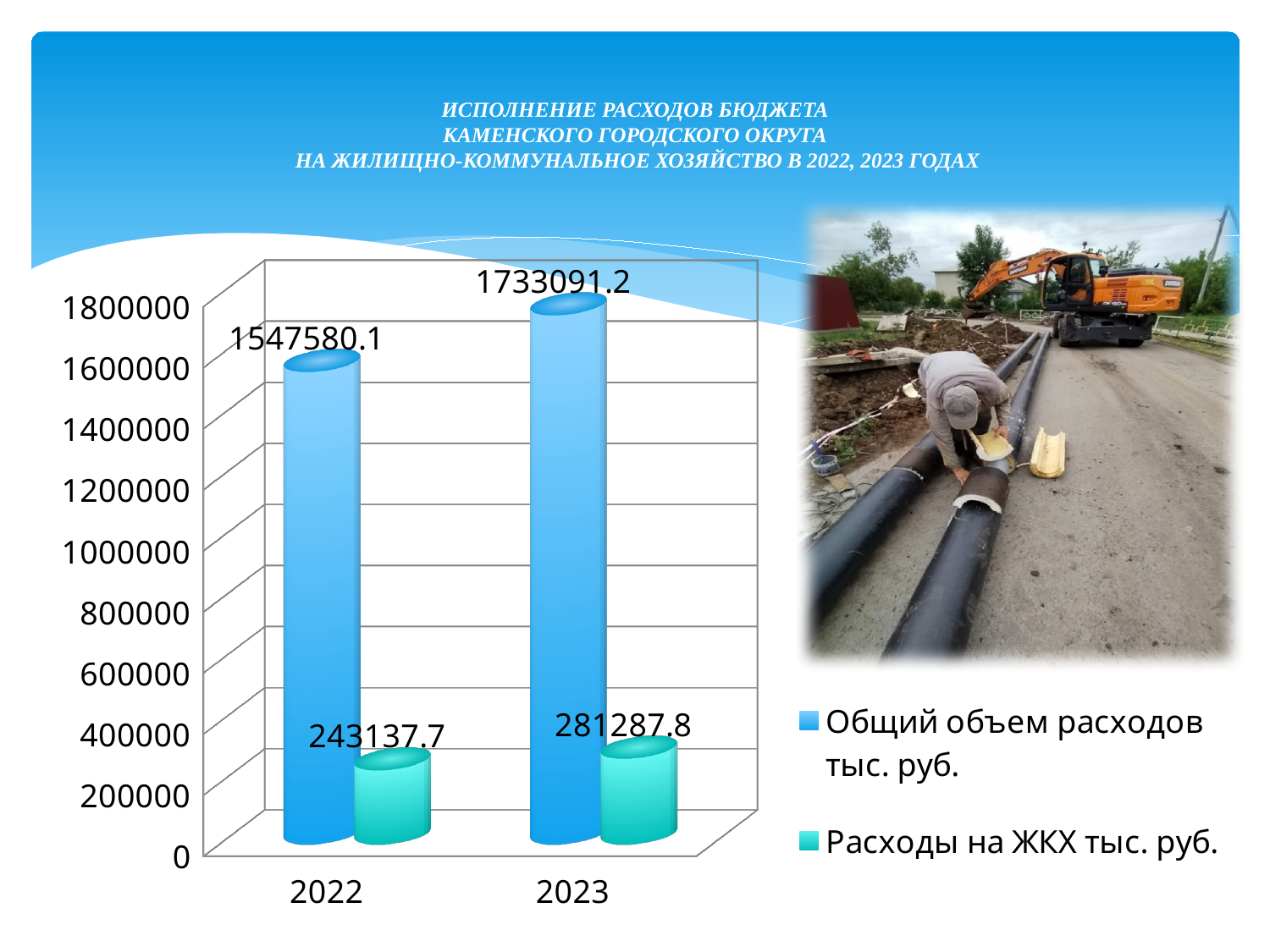
Is the value for "Расходы на ЖКХ тыс. руб." in 2023 greater or less than 400000? less How many series does the chart legend list? 2 What is the value of "Общий объем расходов тыс. руб." for 2022? 1547580.1 What is the value of "Расходы на ЖКХ тыс. руб." for 2023? 281287.8 What type of chart is shown on the slide? Bar chart Which year has the lower value for "Расходы на ЖКХ тыс. руб."? 2022 What is the value of "Расходы на ЖКХ тыс. руб." for 2022? 243137.7 What is the difference between "Расходы на ЖКХ тыс. руб." in 2023 and in 2022? 38150.1 By how much did "Общий объем расходов тыс. руб." increase from 2022 to 2023? 185511.1 What is the value of "Общий объем расходов тыс. руб." for 2023? 1733091.2 How many years (categories) are shown on the x axis of the chart? 2 Which year has the higher value for "Общий объем расходов тыс. руб."? 2023